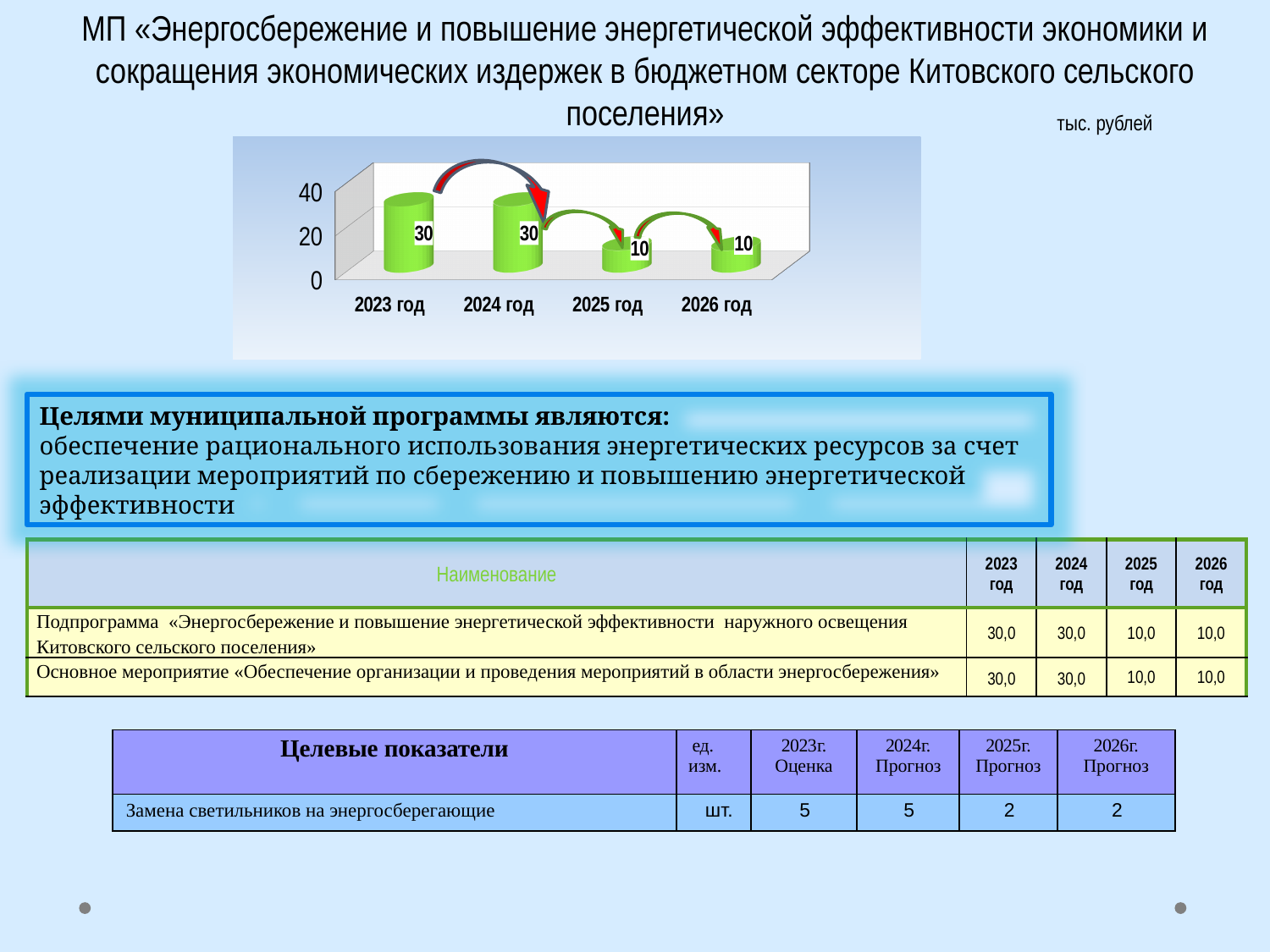
Is the value for 2024 год in the chart greater or less than 20? greater What is the difference between the values for 2024 год and 2025 год in the chart? 20 Is the value for 2025 год in the chart greater or less than 20? less What is the value for 2023 год in the chart? 30 What unit of measurement is indicated next to the chart? тыс. рублей What kind of chart is shown on the slide? bar chart Which is larger in the chart, the value for 2023 год or the value for 2026 год? 2023 год What is the value for 2026 год in the chart? 10 What is the value for 2024 год in the chart? 30 How many categories (years) are shown on the x axis of the chart? 4 Do the values in the chart rise or fall from 2023 год to 2026 год? fall What is the value for 2025 год in the chart? 10